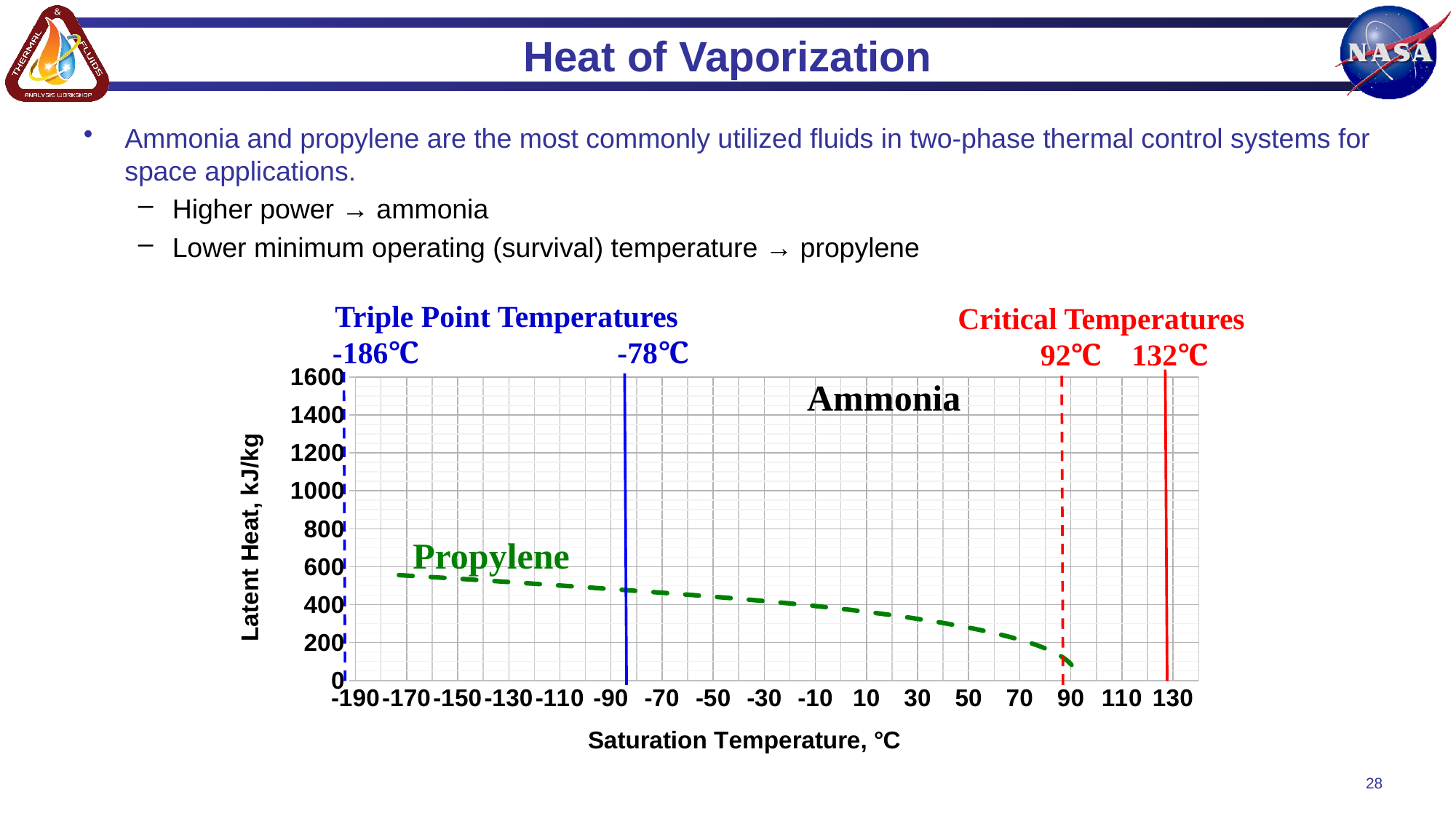
Is the latent heat of propylene at -90 °C greater or less than 600 kJ/kg? less What triple point temperature is marked by the dashed blue vertical line at the left of the chart? -186℃ Does the latent heat of propylene rise or fall as saturation temperature increases? fall What kind of chart is shown on the slide? line chart What two critical temperatures are marked on the chart? 92℃ and 132℃ What triple point temperature is marked by the solid blue vertical line? -78℃ Is the latent heat of propylene at 90 °C greater or less than 200 kJ/kg? less Which has the larger latent heat for propylene: a saturation temperature of -150 °C or 50 °C? -150 °C Is the latent heat of propylene at 70 °C greater or less than 400 kJ/kg? less What is the label of the x-axis of the chart? Saturation Temperature, °C What is the label of the y-axis of the chart? Latent Heat, kJ/kg